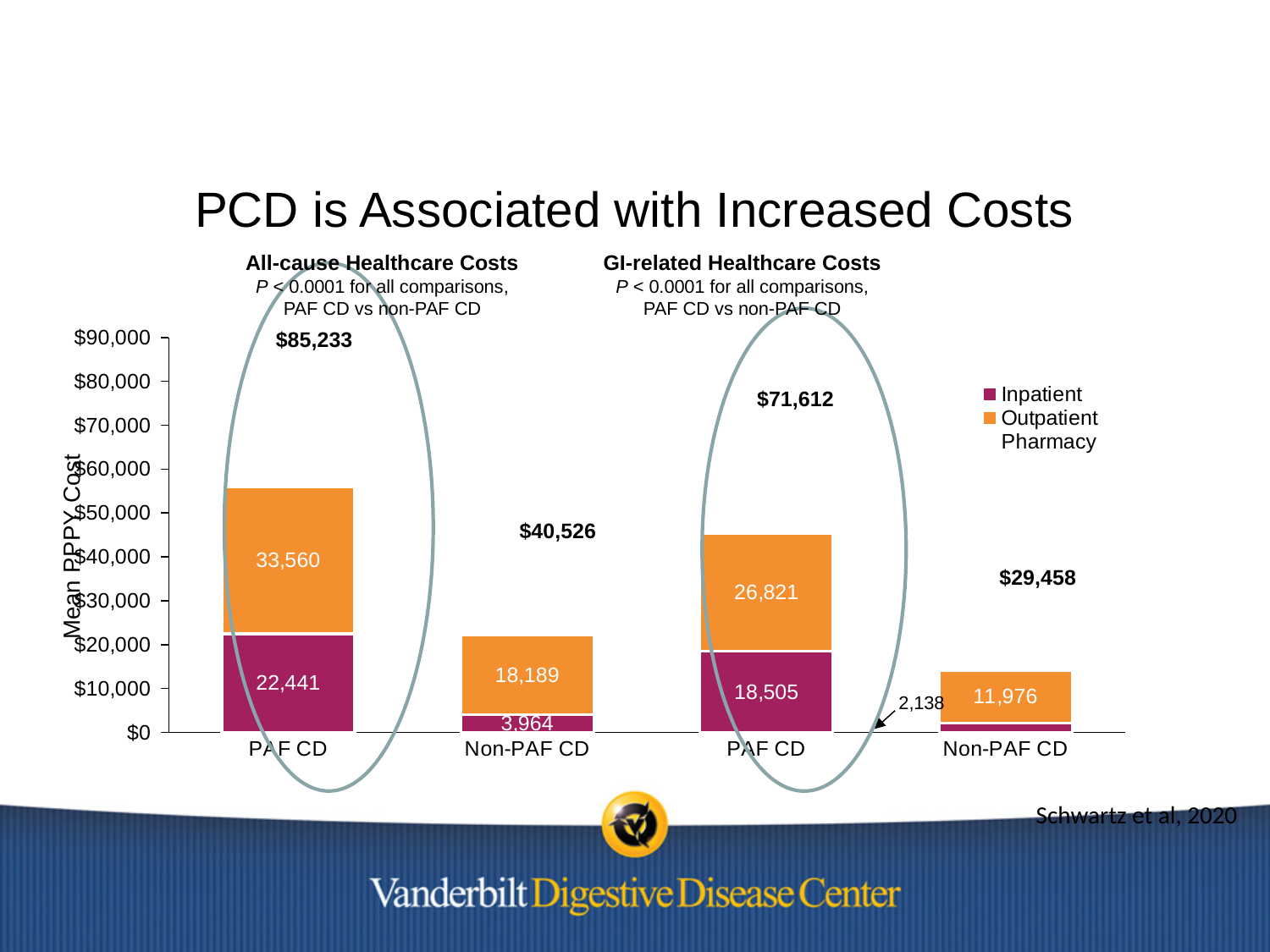
Which bar has the highest Inpatient cost? PAF CD (All-cause Healthcare Costs) What is the Outpatient Pharmacy cost for Non-PAF CD in the GI-related Healthcare Costs group? 11,976 What is the Inpatient cost for PAF CD in the All-cause Healthcare Costs group? 22,441 Which bar has the lowest Inpatient cost? Non-PAF CD (GI-related Healthcare Costs) What total mean PPPY cost is printed above the Non-PAF CD bar in the GI-related Healthcare Costs group? $29,458 In the All-cause Healthcare Costs group, how much higher is the Inpatient cost for PAF CD than for Non-PAF CD? 18,477 Which is larger: the Outpatient Pharmacy cost for All-cause PAF CD or for GI-related PAF CD? All-cause PAF CD What kind of chart is shown on the slide? Stacked bar chart What total mean PPPY cost is printed above the PAF CD bar in the All-cause Healthcare Costs group? $85,233 In the GI-related Healthcare Costs group, what is the difference in Outpatient Pharmacy cost between PAF CD and Non-PAF CD? 14,845 How many series does the legend list? 3 Is the top of the stacked bar for PAF CD in the All-cause Healthcare Costs group greater or less than $50,000? greater